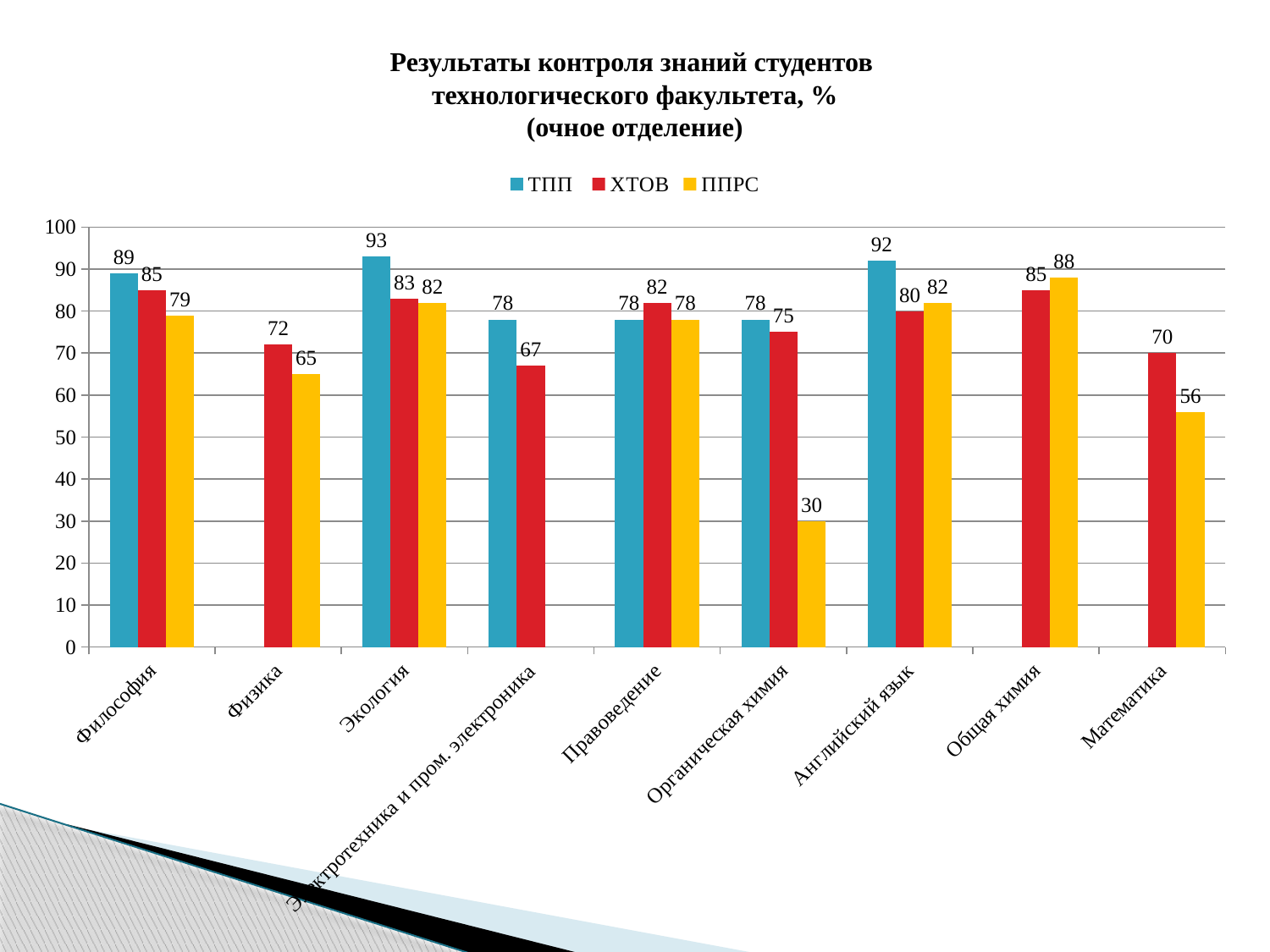
How many categories are shown on the x axis? 9 What is the value for ППРС in Органическая химия? 30 Which category has the lowest ППРС value? Органическая химия How many series does the legend list? 3 What is the value for ХТОВ in Математика? 70 Which category has the highest ТПП value? Экология What kind of chart is shown on the slide? Bar chart What is the difference between the ТПП and ХТОВ values for Философия? 4 Which series is shown in yellow in the legend? ППРС Which is larger in Общая химия: ХТОВ or ППРС? ППРС What is the difference between the ХТОВ and ППРС values for Математика? 14 What is the value for ТПП in Экология? 93